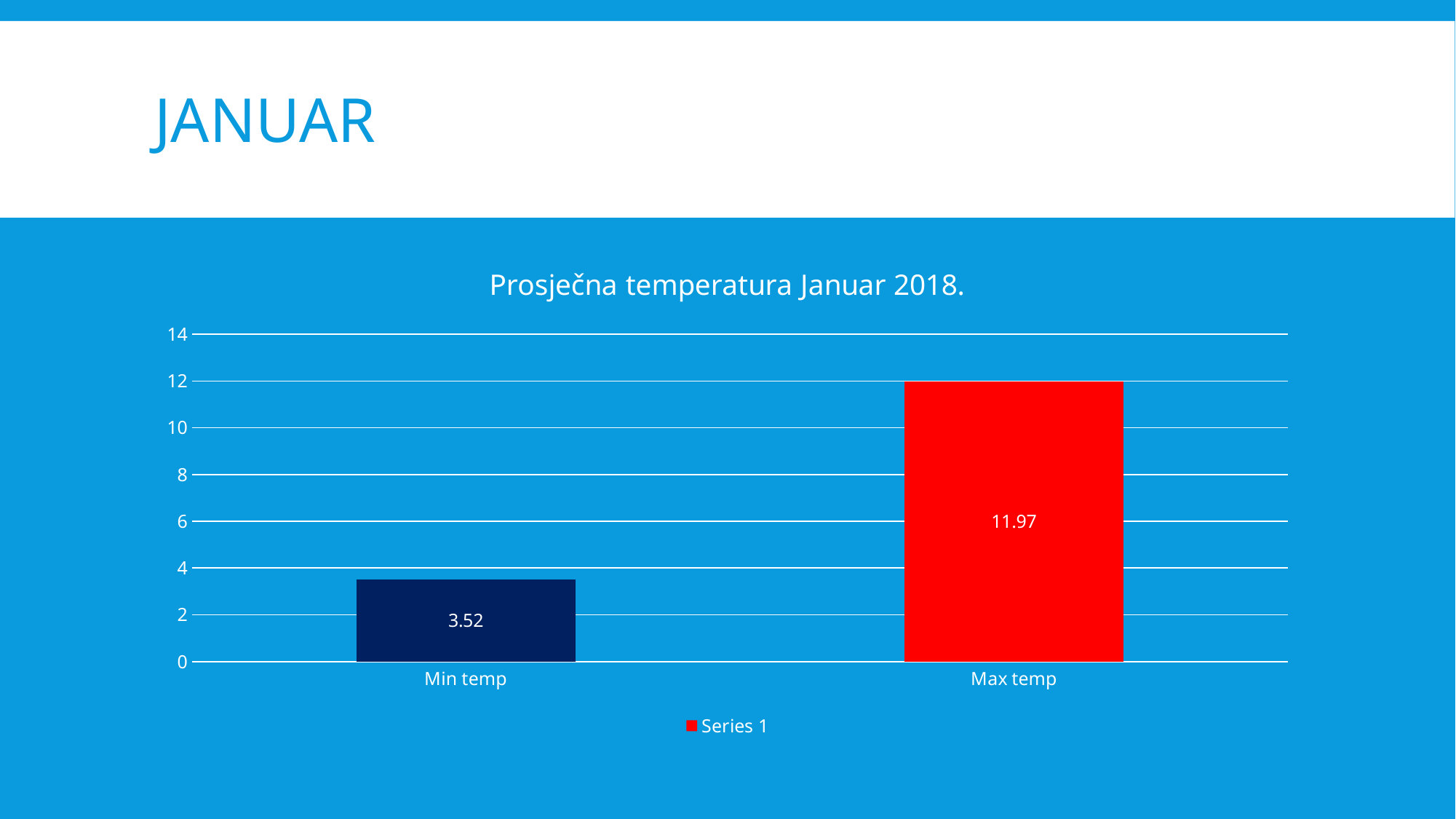
Is the value for Min temp greater or less than 4? less Which category has the highest value? Max temp How many categories are shown on the x axis? 2 What is the value for Max temp? 11.97 Which category has the lowest value? Min temp Is the value for Max temp greater or less than 10? greater How many series does the legend list? 1 What is the value for Min temp? 3.52 Which is larger, the value for Min temp or the value for Max temp? Max temp What is the title of the chart? Prosječna temperatura Januar 2018. What is the difference between the Max temp and Min temp values? 8.45 What kind of chart is shown on the slide? bar chart